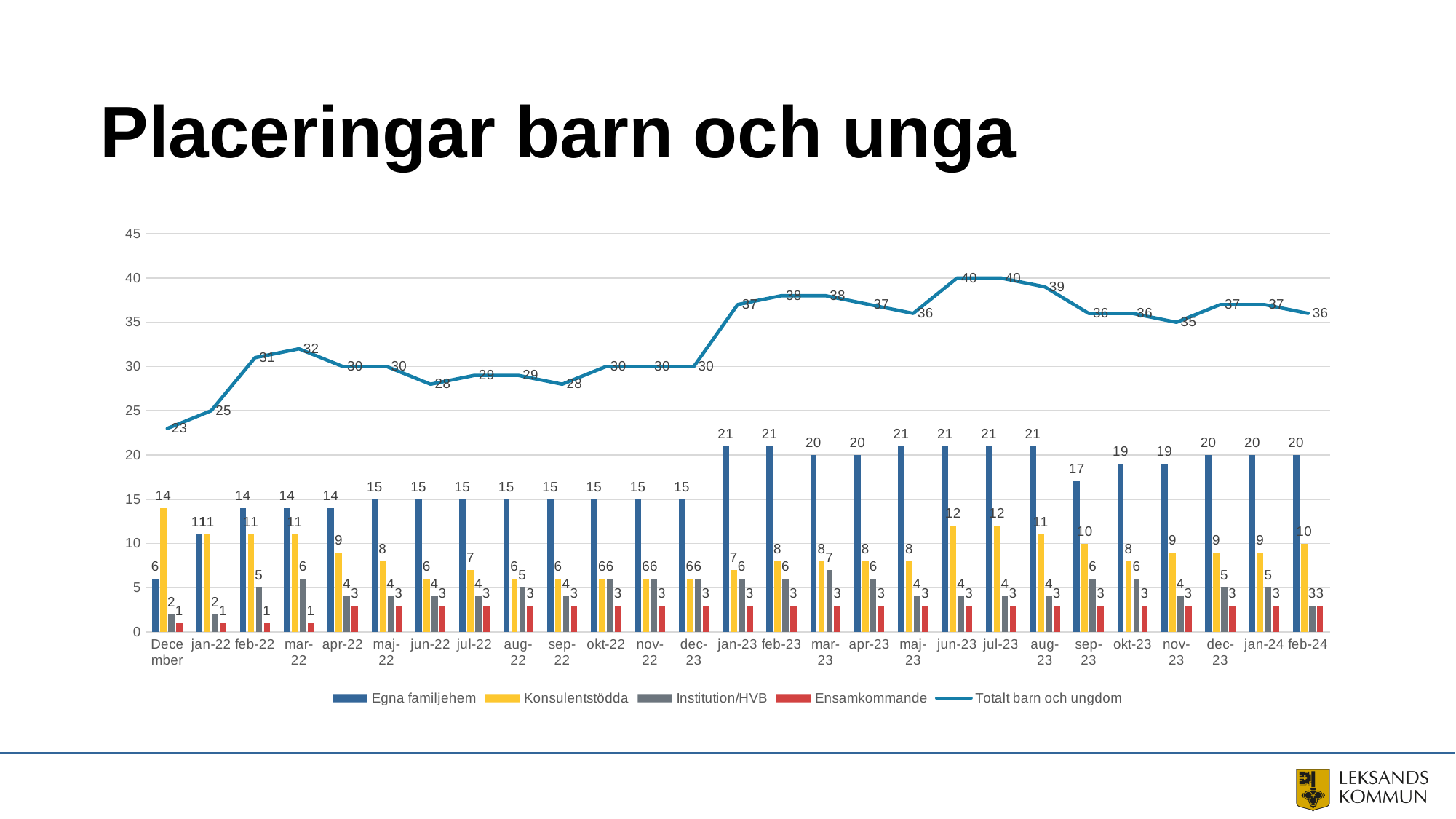
How many series does the legend list? 5 In which month is Totalt barn och ungdom lowest? December What is the value of Konsulentstödda in jun-23? 12 What is the value of Egna familjehem in sep-23? 17 What is the value of Totalt barn och ungdom in sep-23? 36 Is the value of Totalt barn och ungdom in jan-23 greater or less than 35? greater What is the highest value reached by the Totalt barn och ungdom line? 40 In December, which is larger: Egna familjehem or Konsulentstödda? Konsulentstödda What is the difference between Totalt barn och ungdom in jan-24 and in feb-24? 1 What kind of chart is shown on the slide? Combined bar and line chart